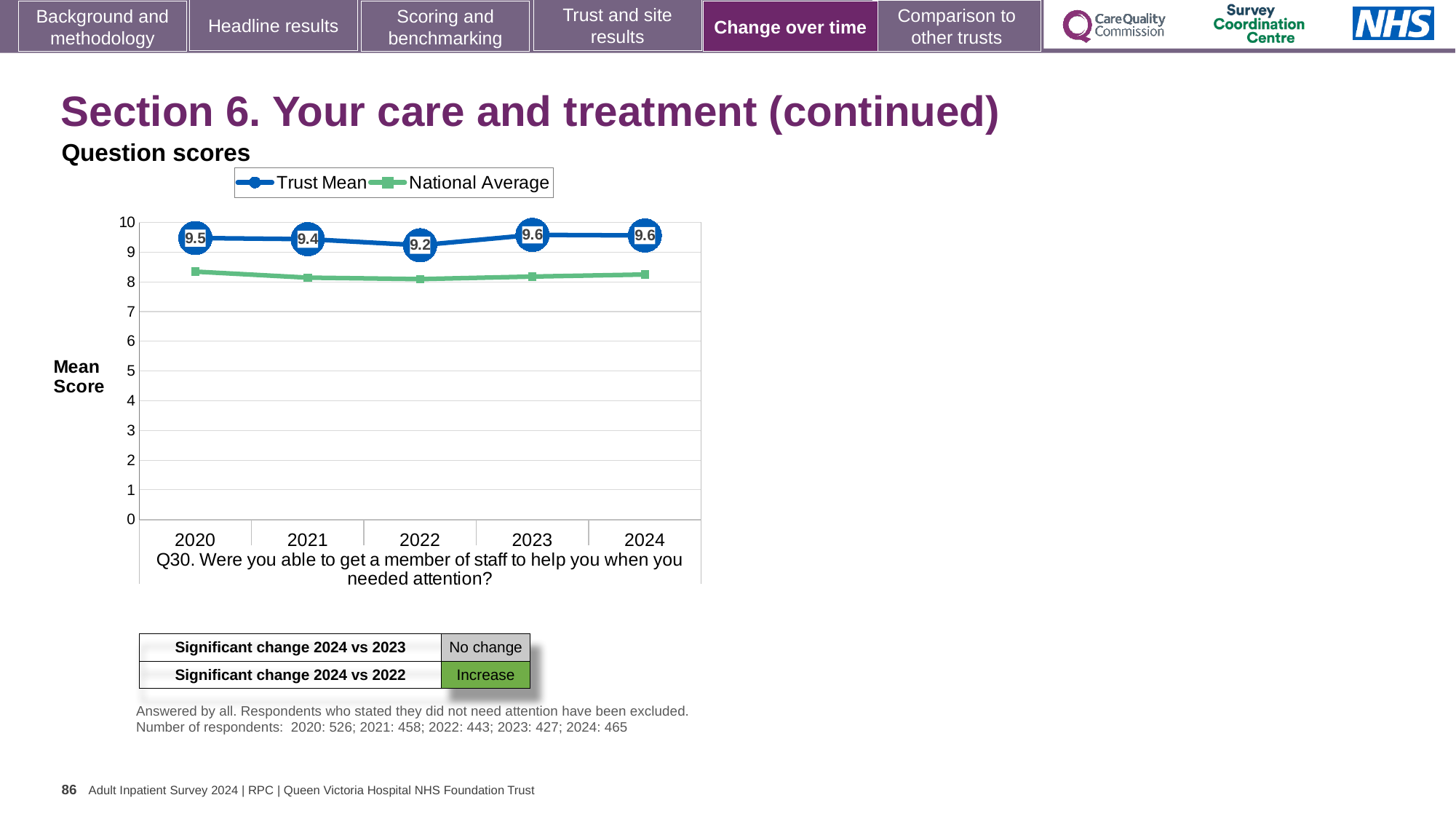
What kind of chart is shown? line chart In which year is the Trust Mean score lowest? 2022 How many series does the legend list? 2 What is the difference between the Trust Mean scores for 2023 and 2022? 0.4 Is the National Average value for 2020 greater or less than 8? greater Is the National Average value for 2022 greater or less than 9? less How many years are shown on the x axis? 5 Which is larger, the Trust Mean score for 2021 or for 2022? 2021 What is the Trust Mean score for 2024? 9.6 What is the Trust Mean score for 2020? 9.5 Which series is plotted in green? National Average What is the Trust Mean score for 2022? 9.2